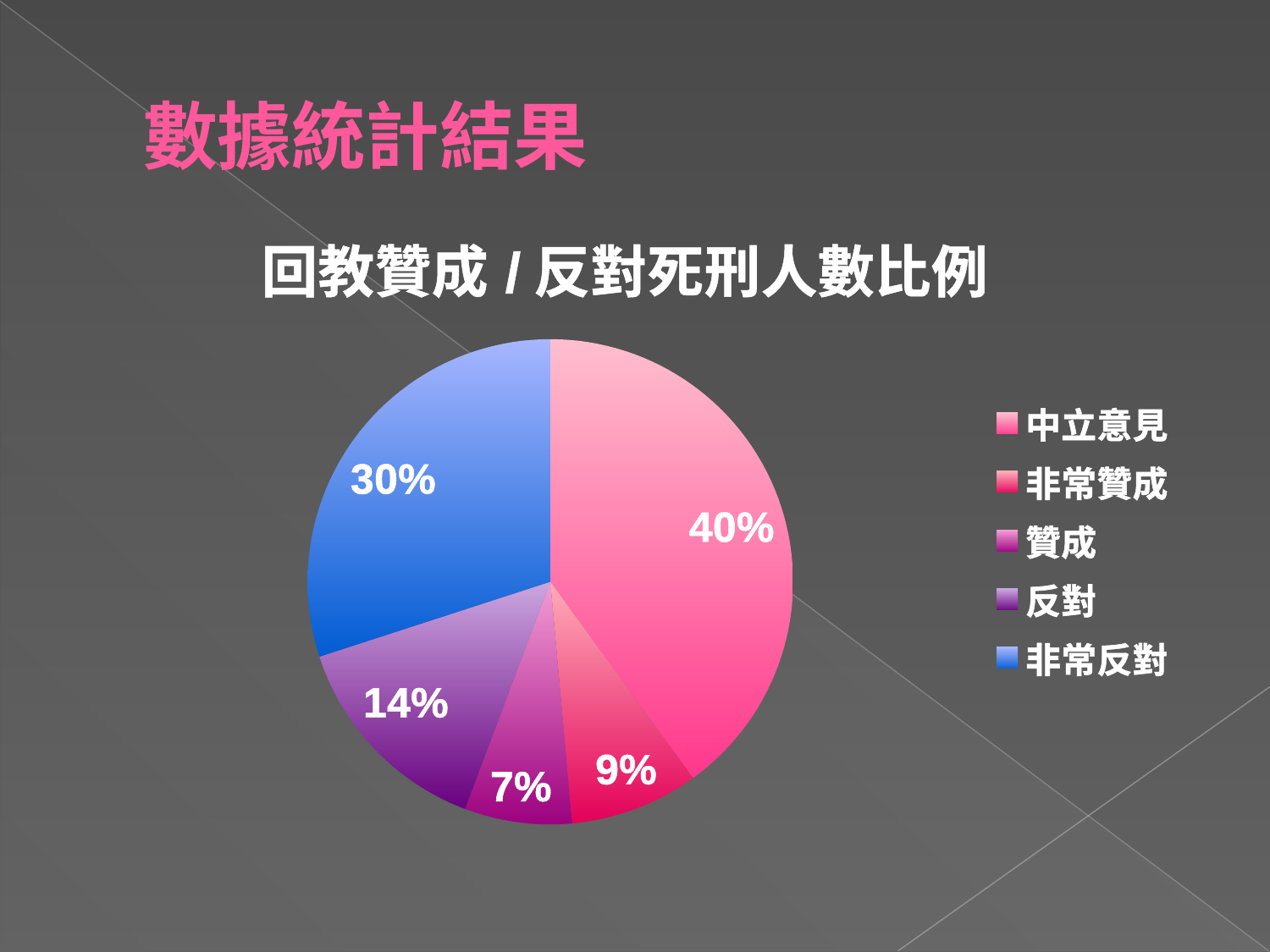
How many categories does the legend list? 5 Which is larger, the share of 反對 or the share of 非常贊成? 反對 What share of the pie is 非常贊成? 9% Which category has the smallest slice of the pie? 贊成 What share of the pie is 非常反對? 30% What share of the pie is 反對? 14% What is the title of the chart? 回教贊成 / 反對死刑人數比例 What is the difference between the shares of 中立意見 and 非常反對? 10% Which category has the largest slice of the pie? 中立意見 What kind of chart is shown on the slide? Pie chart